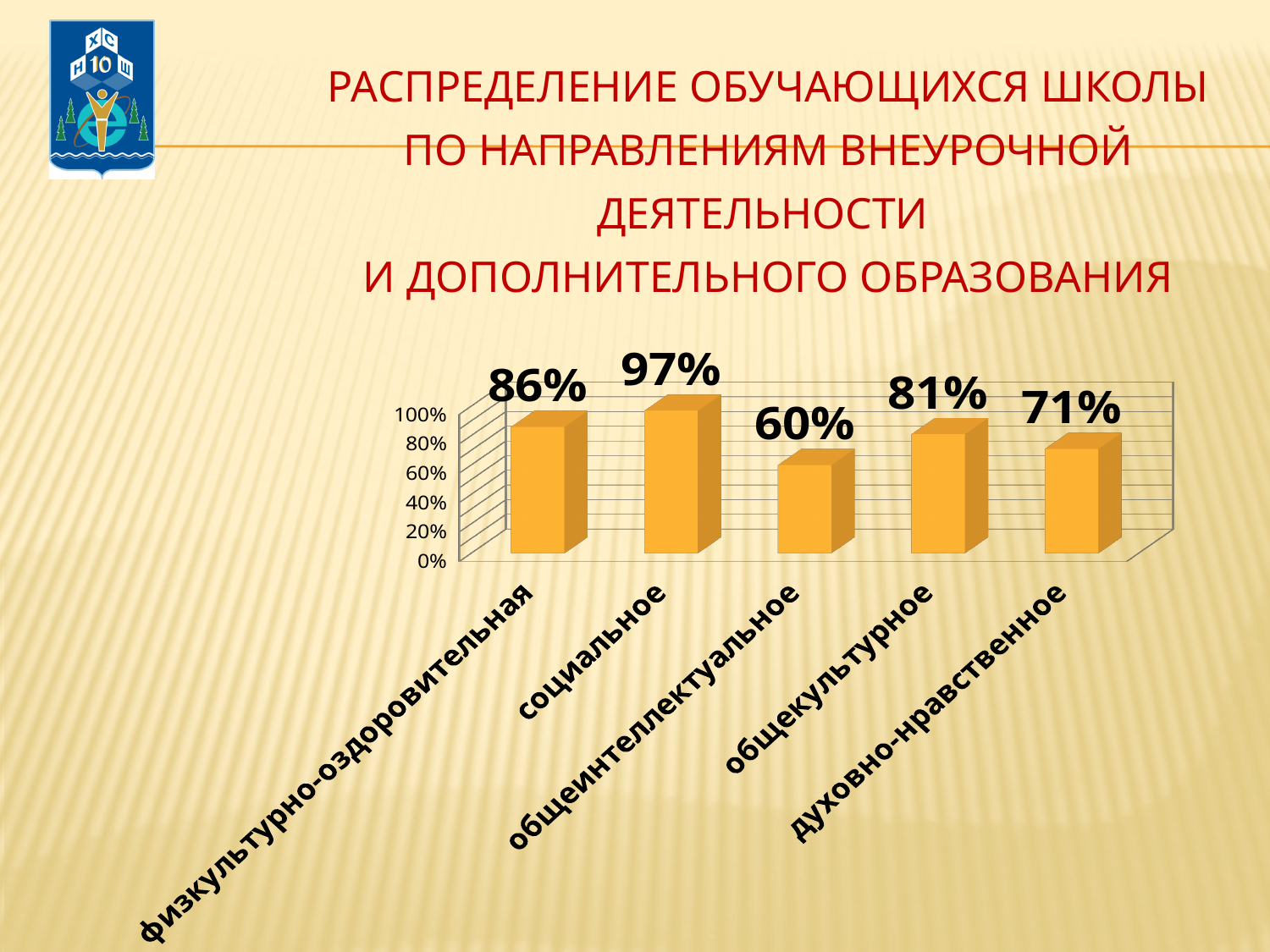
What is the maximum value shown on the vertical axis? 100% How many categories are shown in the chart? 5 Which category has the highest value? социальное Which is larger, the value for общекультурное or the value for духовно-нравственное? общекультурное What is the value for общеинтеллектуальное? 60% What is the value for социальное? 97% What is the value for физкультурно-оздоровительная? 86% What kind of chart is shown on the slide? bar chart What is the value for духовно-нравственное? 71% What is the difference between the values for физкультурно-оздоровительная and общекультурное? 5% Which category has the lowest value? общеинтеллектуальное What is the difference between the values for социальное and общеинтеллектуальное? 37%